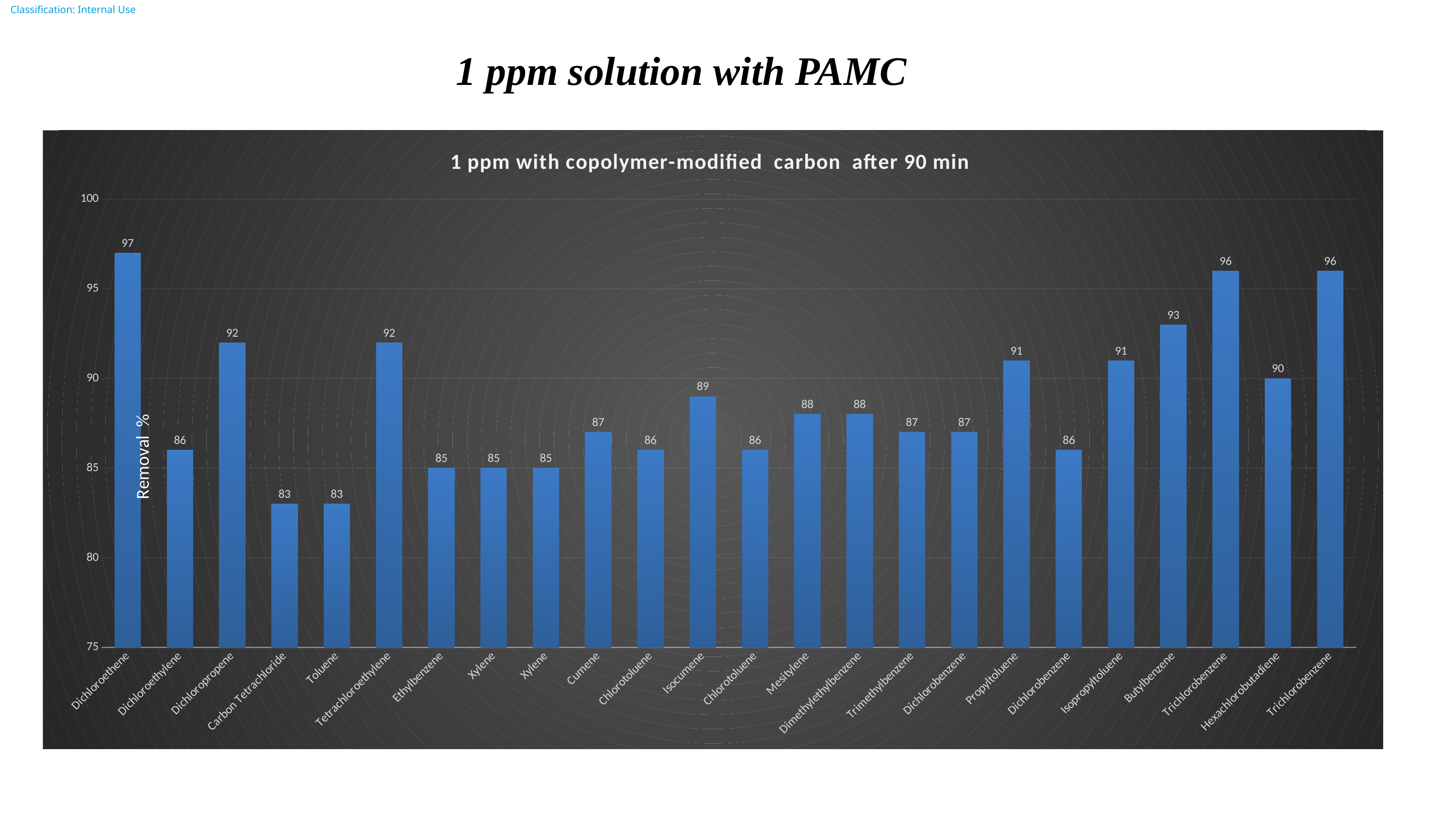
Which has a higher removal %, Propyltoluene or Mesitylene? Propyltoluene How many bars are plotted on the chart? 24 What is the removal % for Carbon Tetrachloride? 83 What is the title of the chart? 1 ppm with copolymer-modified carbon after 90 min What is the difference in removal % between Dichloroethene and Toluene? 14 What is the lowest removal % shown on the chart? 83 What type of chart is shown on the slide? Bar chart What is the removal % for Dichloroethene? 97 What is the removal % for Hexachlorobutadiene? 90 Which compound has the highest removal %? Dichloroethene What is the removal % for Butylbenzene? 93 What is the removal % for Isocumene? 89